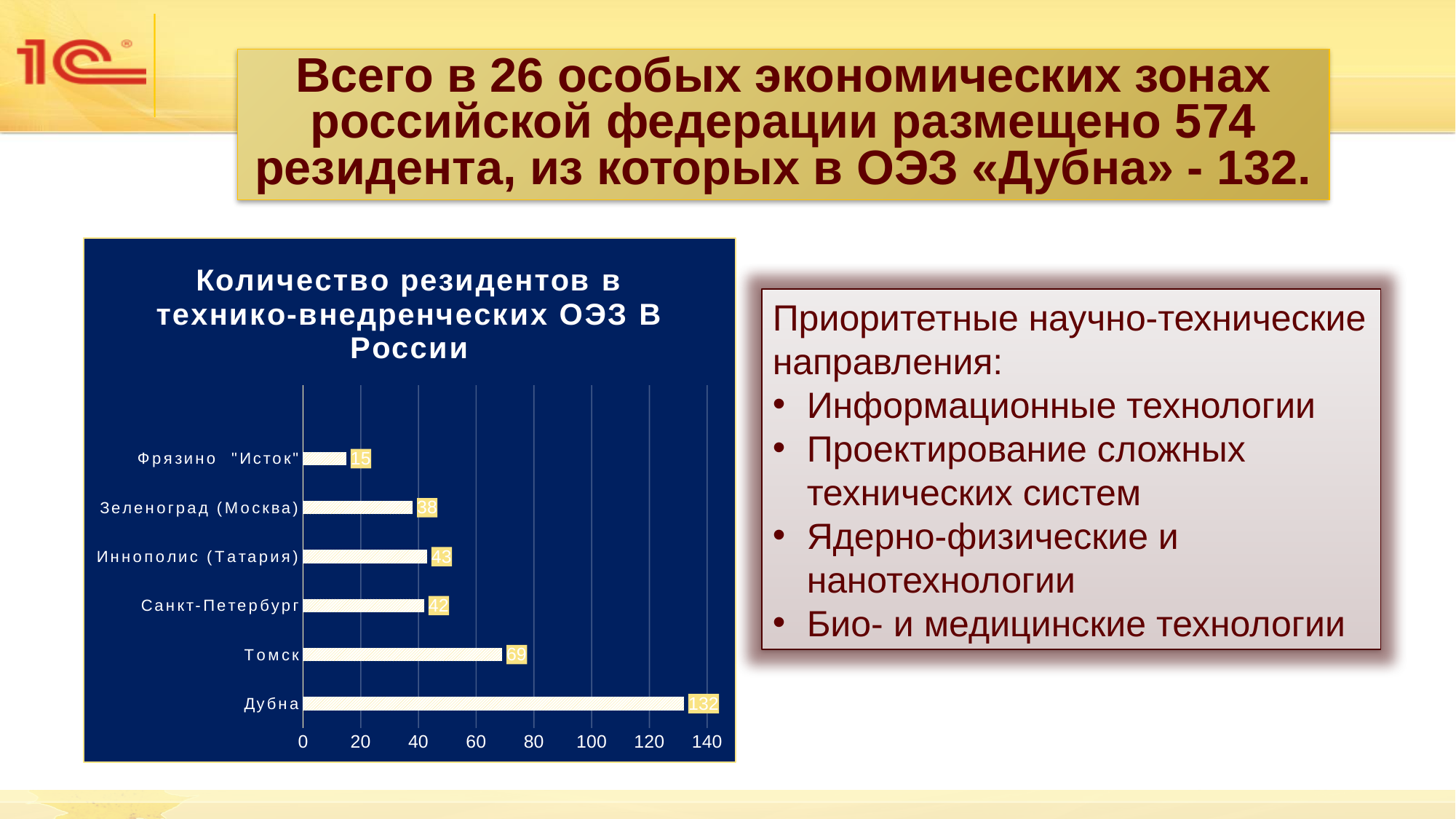
What is the value for Дубна? 132 What is the difference between the values for Дубна and Томск? 63 Which category has the lowest value? Фрязино "Исток" What is the title of the chart? Количество резидентов в технико-внедренческих ОЭЗ В России What is the value for Иннополис (Татария)? 43 Which is larger, the value for Зеленоград (Москва) or the value for Санкт-Петербург? Санкт-Петербург What is the value for Фрязино "Исток"? 15 Is the value for Томск greater or less than 60? greater Which category has the highest value? Дубна What is the value for Томск? 69 How many categories are shown in the chart? 6 What kind of chart is shown on the slide? bar chart